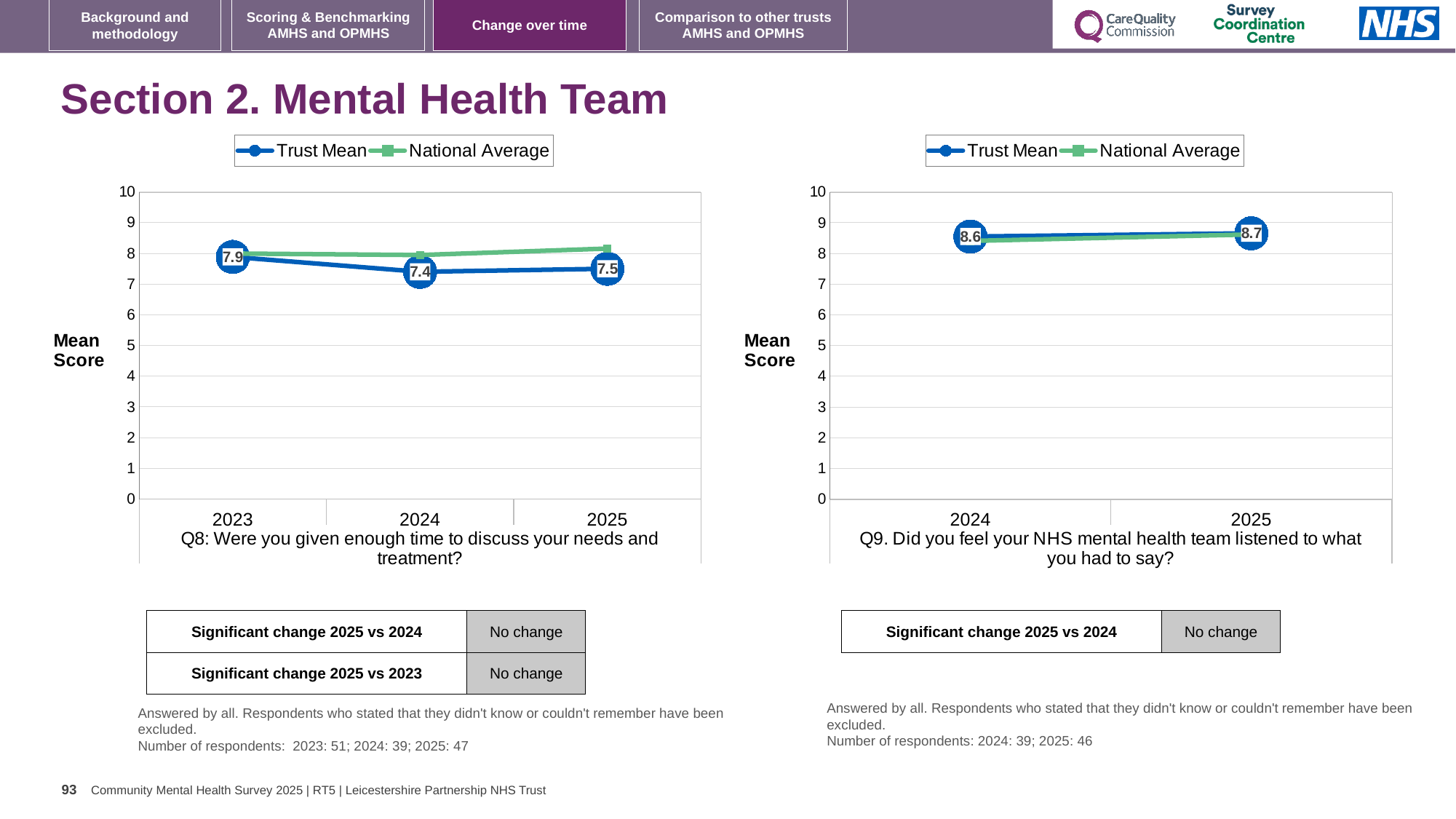
In the Q8 chart on the left, what is the difference between the Trust Mean scores for 2023 and 2024? 0.5 In the Q8 chart on the left, which year has the lowest Trust Mean score? 2024 In the Q9 chart on the right, what is the Trust Mean score for 2025? 8.7 In the Q8 chart on the left, what is the Trust Mean score for 2024? 7.4 In the Q8 chart on the left, which year has the highest Trust Mean score? 2023 In the Q8 chart on the left, for 2024, which is higher: the Trust Mean or the National Average? National Average In the Q8 chart on the left, what is the Trust Mean score for 2025? 7.5 How many years are shown on the x axis of the Q9 chart on the right? 2 In the Q9 chart on the right, what is the Trust Mean score for 2024? 8.6 In the Q8 chart on the left, what is the Trust Mean score for 2023? 7.9 What type of chart is the Q8 chart on the left? Line chart In the Q9 chart on the right, what is the difference between the Trust Mean scores for 2025 and 2024? 0.1